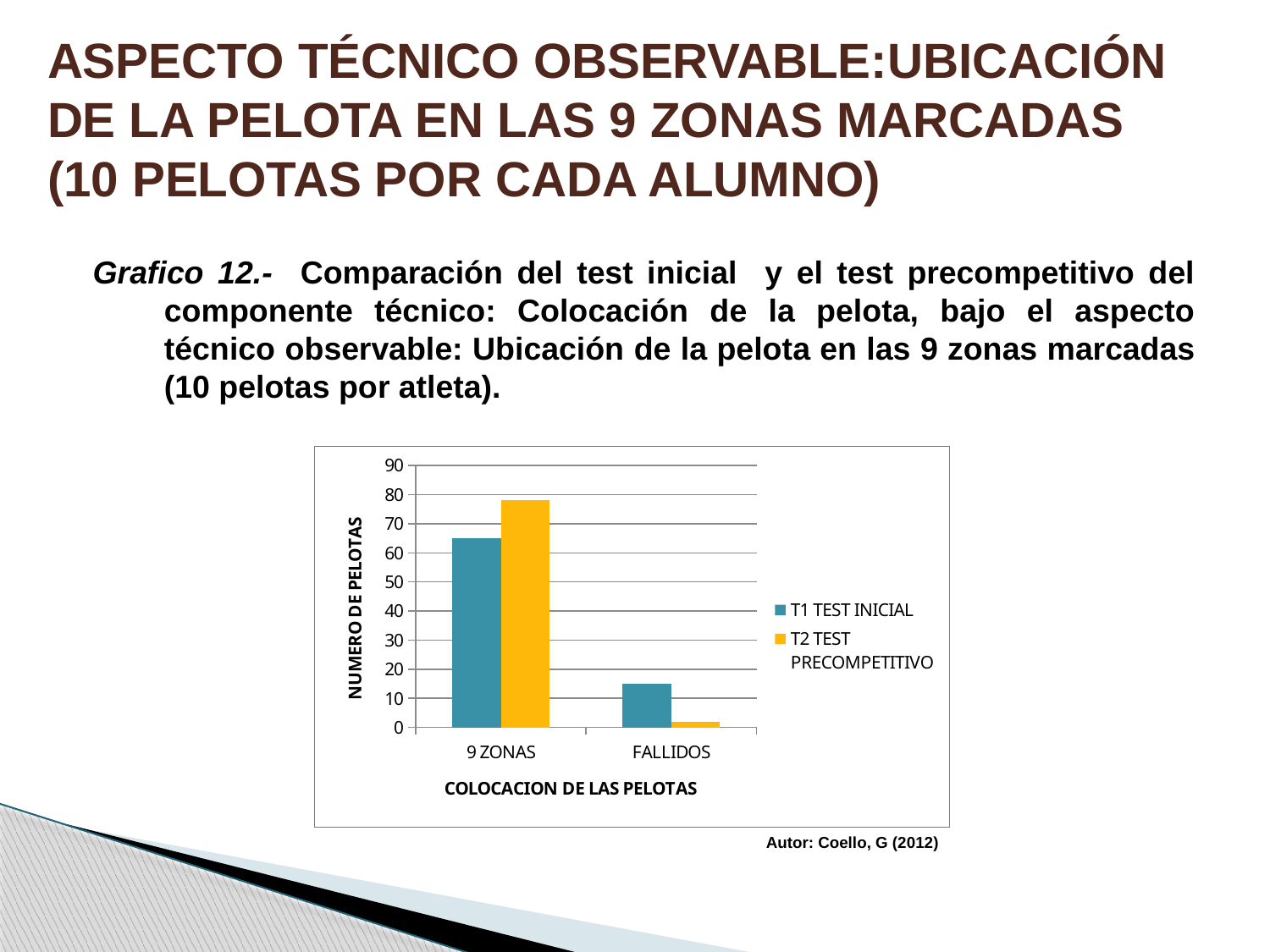
What kind of chart is shown on the slide? bar chart Is the value for T2 TEST PRECOMPETITIVO in the 9 ZONAS category greater or less than 70? greater Is the value for T2 TEST PRECOMPETITIVO in the FALLIDOS category greater or less than 10? less In the FALLIDOS category, which series has the larger value, T1 TEST INICIAL or T2 TEST PRECOMPETITIVO? T1 TEST INICIAL In the 9 ZONAS category, which series has the larger value, T1 TEST INICIAL or T2 TEST PRECOMPETITIVO? T2 TEST PRECOMPETITIVO Is the value for T1 TEST INICIAL in the FALLIDOS category greater or less than 20? less How many series does the legend list? 2 Which category has the lowest value for T2 TEST PRECOMPETITIVO? FALLIDOS How many categories are shown on the x axis? 2 What is the label of the vertical axis of the chart? NUMERO DE PELOTAS